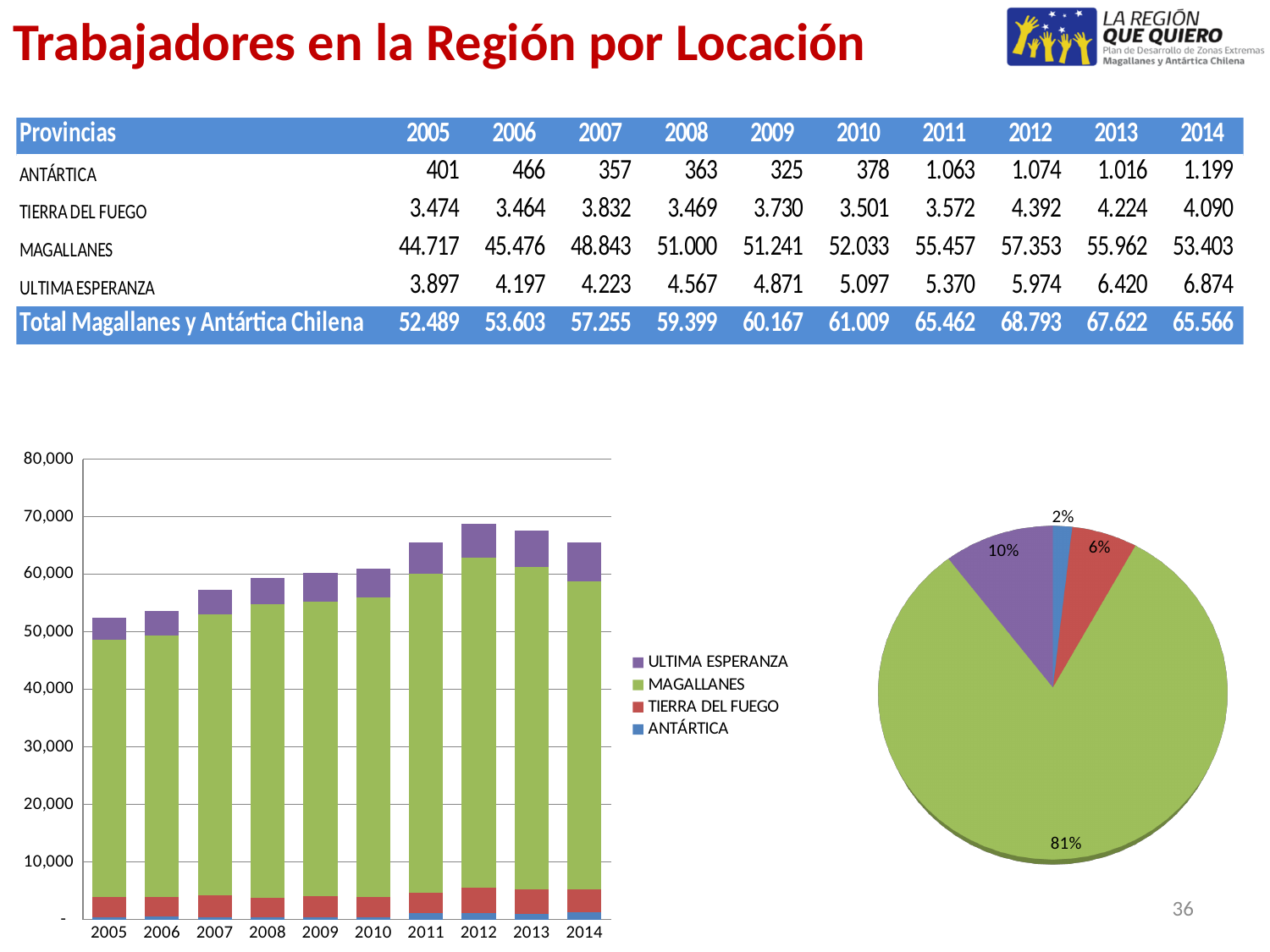
In the bar chart, is the total for 2012 greater or less than 60,000? greater In the bar chart, how many years are shown on the x axis? 10 What kind of chart is the chart on the left of the slide? stacked bar chart In the bar chart, is the stacked bar for 2012 taller or shorter than the bar for 2014? taller In the bar chart, do the stacked totals generally rise or fall from 2005 to 2012? rise What kind of chart is the chart on the right of the slide? pie chart In the bar chart, is the total for 2005 greater or less than 60,000? less How many series does the legend of the bar chart list? 4 In the bar chart, which year has the shortest stacked bar? 2005 In the pie chart, what share does the smallest (blue) slice have? 2% In the bar chart, which year has the tallest stacked bar? 2012 In the pie chart, what share does the largest (green) slice have? 81%